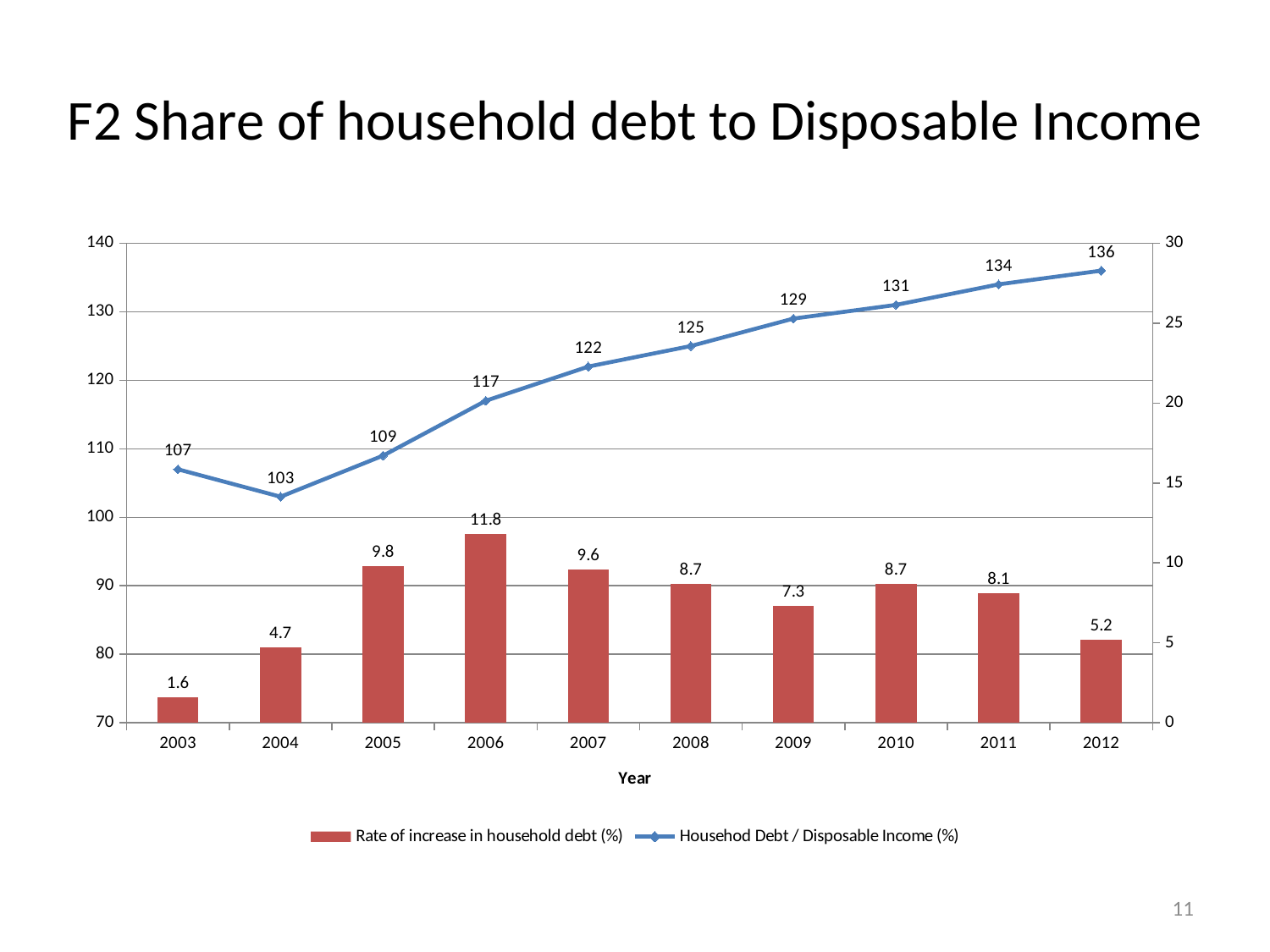
Which year has the larger Rate of increase in household debt (%), 2005 or 2007? 2005 What is the difference between the Household Debt / Disposable Income (%) values for 2012 and 2003? 29 What is the label of the x axis? Year Which year has the highest Rate of increase in household debt (%)? 2006 Does the Household Debt / Disposable Income (%) series rise or fall from 2004 to 2012? Rise What kind of chart is used for the Rate of increase in household debt (%) series? Bar chart How many years are shown on the x axis? 10 What is the Household Debt / Disposable Income (%) value for 2008? 125 What is the Rate of increase in household debt (%) for 2003? 1.6 How many series does the legend list? 2 What is the Rate of increase in household debt (%) for 2006? 11.8 Which year has the lowest Household Debt / Disposable Income (%) value? 2004